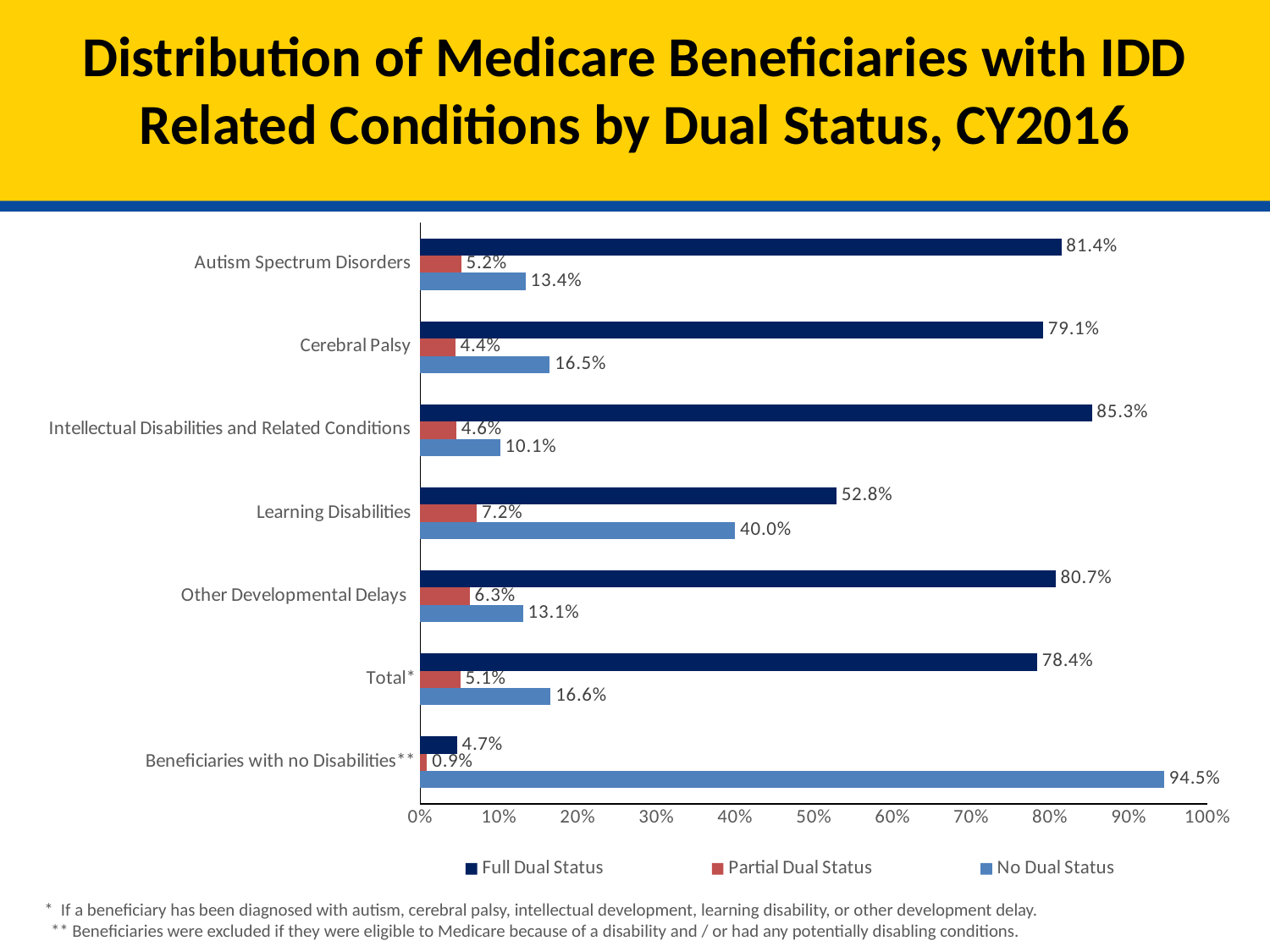
Which is larger: the No Dual Status value for Cerebral Palsy or for Other Developmental Delays? Cerebral Palsy What is the Partial Dual Status value for Cerebral Palsy? 4.4% What is the No Dual Status value for Learning Disabilities? 40.0% What is the Full Dual Status value for Autism Spectrum Disorders? 81.4% Is the Full Dual Status value for Total* greater or less than 70%? greater How many series does the legend list? 3 What is the No Dual Status value for Beneficiaries with no Disabilities**? 94.5% Which category has the highest Full Dual Status value? Intellectual Disabilities and Related Conditions What is the difference between the Full Dual Status values for Intellectual Disabilities and Related Conditions and Learning Disabilities? 32.5% How many categories are shown on the y axis? 7 What kind of chart is shown on the slide? Bar chart Which category has the lowest Partial Dual Status value? Beneficiaries with no Disabilities**